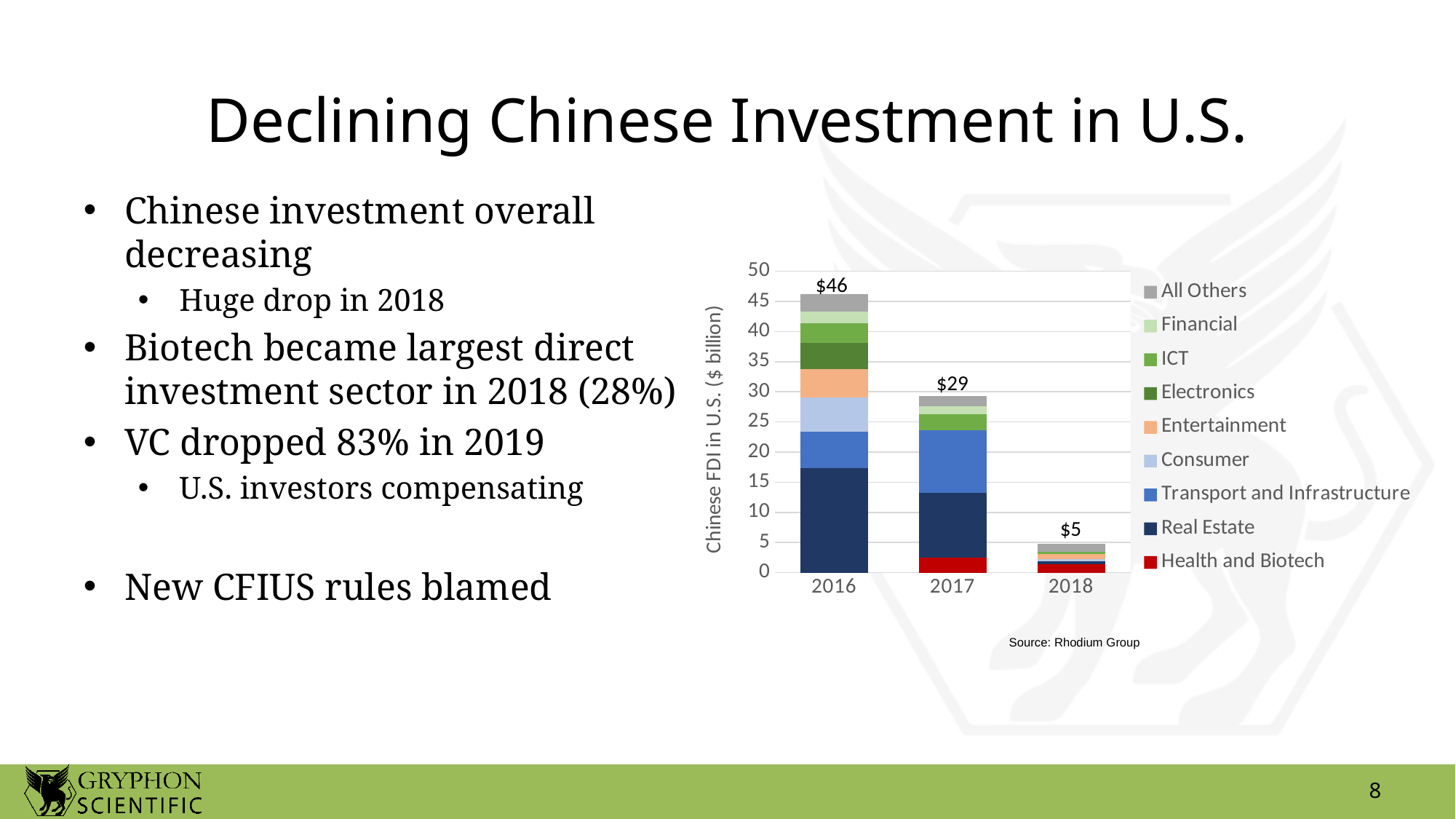
Is the Real Estate value for 2016 greater or less than 15? greater What is the total Chinese FDI in the U.S. shown for 2018? $5 Which year has a larger total, 2017 or 2018? 2017 How many years are shown on the x axis of the chart? 3 By how much did the total Chinese FDI in the U.S. fall from 2017 to 2018? $24 Which year has the highest total Chinese FDI in the U.S.? 2016 Which year has the lowest total Chinese FDI in the U.S.? 2018 What is the total Chinese FDI in the U.S. shown for 2016? $46 How many series does the chart legend list? 9 By how much did the total Chinese FDI in the U.S. fall from 2016 to 2017? $17 What is the total Chinese FDI in the U.S. shown for 2017? $29 What kind of chart is shown on the slide? Stacked bar chart